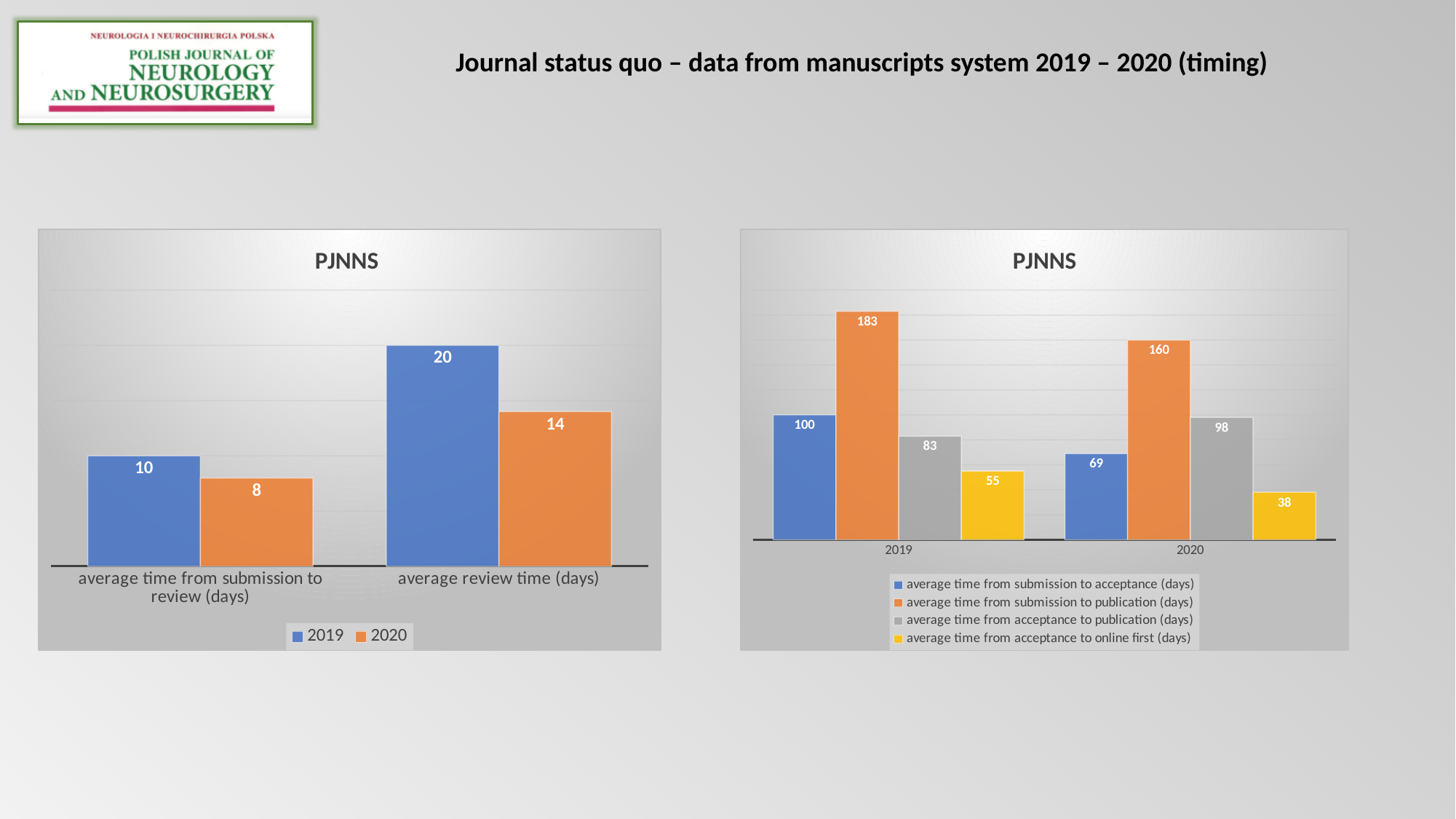
In the right chart, what is the 2019 value for average time from submission to publication (days)? 183 In the right chart, what is the difference between the 2019 and 2020 values for average time from submission to acceptance (days)? 31 In the right chart, which series has the highest value in 2020? average time from submission to publication (days) What kind of chart is the right chart? bar chart In the left chart, what is the 2020 value for average review time (days)? 14 In the right chart, how many series does the legend list? 4 In the right chart, what is the 2020 value for average time from acceptance to online first (days)? 38 In the left chart, what is the 2019 value for average time from submission to review (days)? 10 In the left chart, what is the difference between the 2019 and 2020 values for average review time (days)? 6 In the left chart, which is larger: the 2019 or the 2020 value for average time from submission to review (days)? 2019 In the left chart, how many series does the legend list? 2 In the right chart, which series has the lowest value in 2019? average time from acceptance to online first (days)